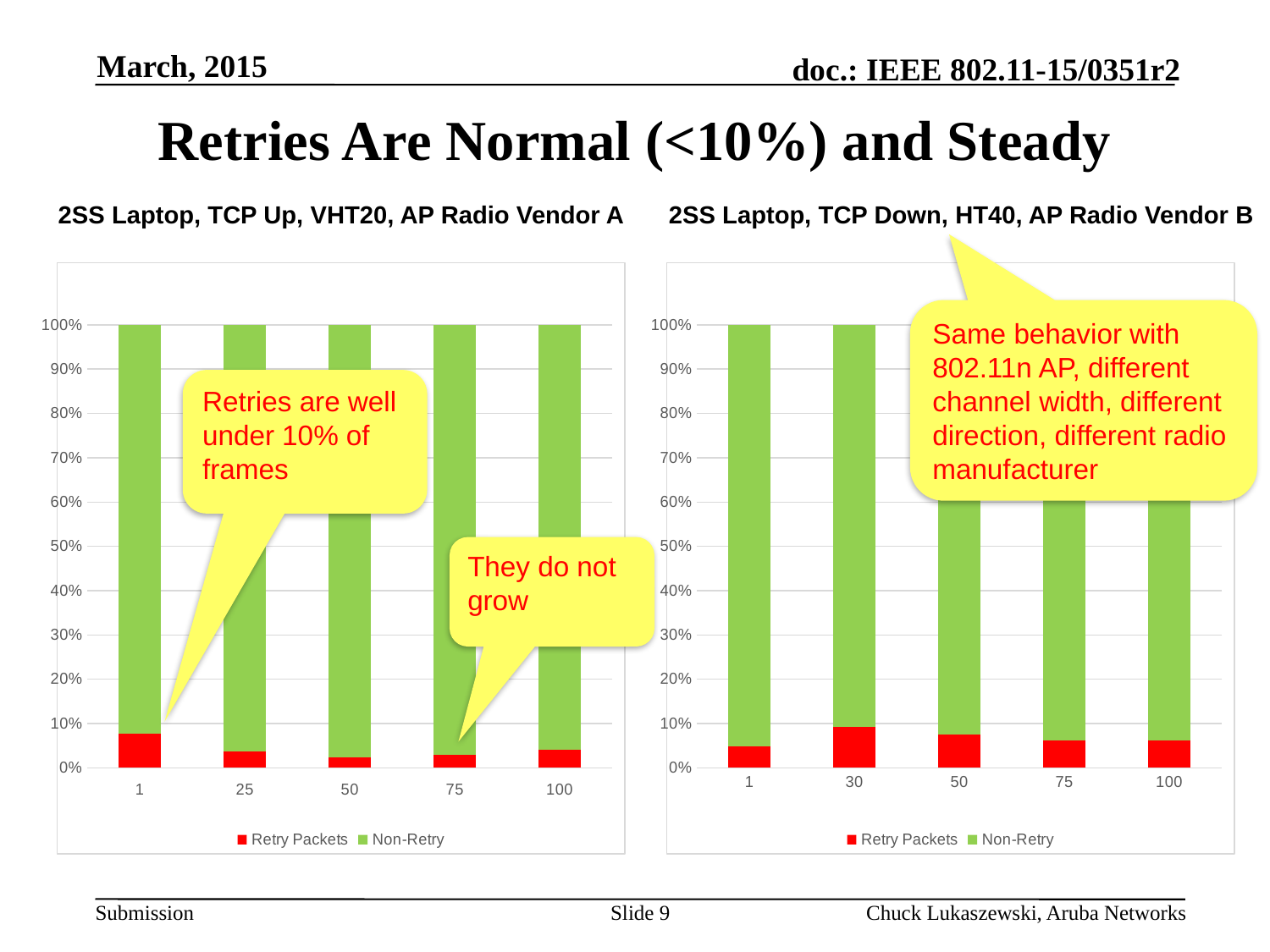
What colour represents the Non-Retry series in the '2SS Laptop, TCP Down, HT40, AP Radio Vendor B' chart? Green In the '2SS Laptop, TCP Up, VHT20, AP Radio Vendor A' chart, which category has the highest Retry Packets share? 1 In the '2SS Laptop, TCP Down, HT40, AP Radio Vendor B' chart, is the Retry Packets share larger for category 30 or category 1? 30 In the '2SS Laptop, TCP Down, HT40, AP Radio Vendor B' chart, is the Retry Packets value for category 1 greater or less than 10%? less What kind of chart is the '2SS Laptop, TCP Up, VHT20, AP Radio Vendor A' chart? Stacked bar chart How many categories are shown on the x axis of the '2SS Laptop, TCP Up, VHT20, AP Radio Vendor A' chart? 5 In the '2SS Laptop, TCP Down, HT40, AP Radio Vendor B' chart, which category has the highest Retry Packets share? 30 How many series does the legend list in the '2SS Laptop, TCP Down, HT40, AP Radio Vendor B' chart? 2 In the '2SS Laptop, TCP Up, VHT20, AP Radio Vendor A' chart, is the Retry Packets value for category 1 greater or less than 10%? less In the '2SS Laptop, TCP Up, VHT20, AP Radio Vendor A' chart, what is the total of the stacked bar for category 25? 100% In the '2SS Laptop, TCP Up, VHT20, AP Radio Vendor A' chart, is the Retry Packets share larger for category 1 or category 50? 1 In the '2SS Laptop, TCP Up, VHT20, AP Radio Vendor A' chart, does the Retry Packets share rise or fall from category 1 to category 50? fall